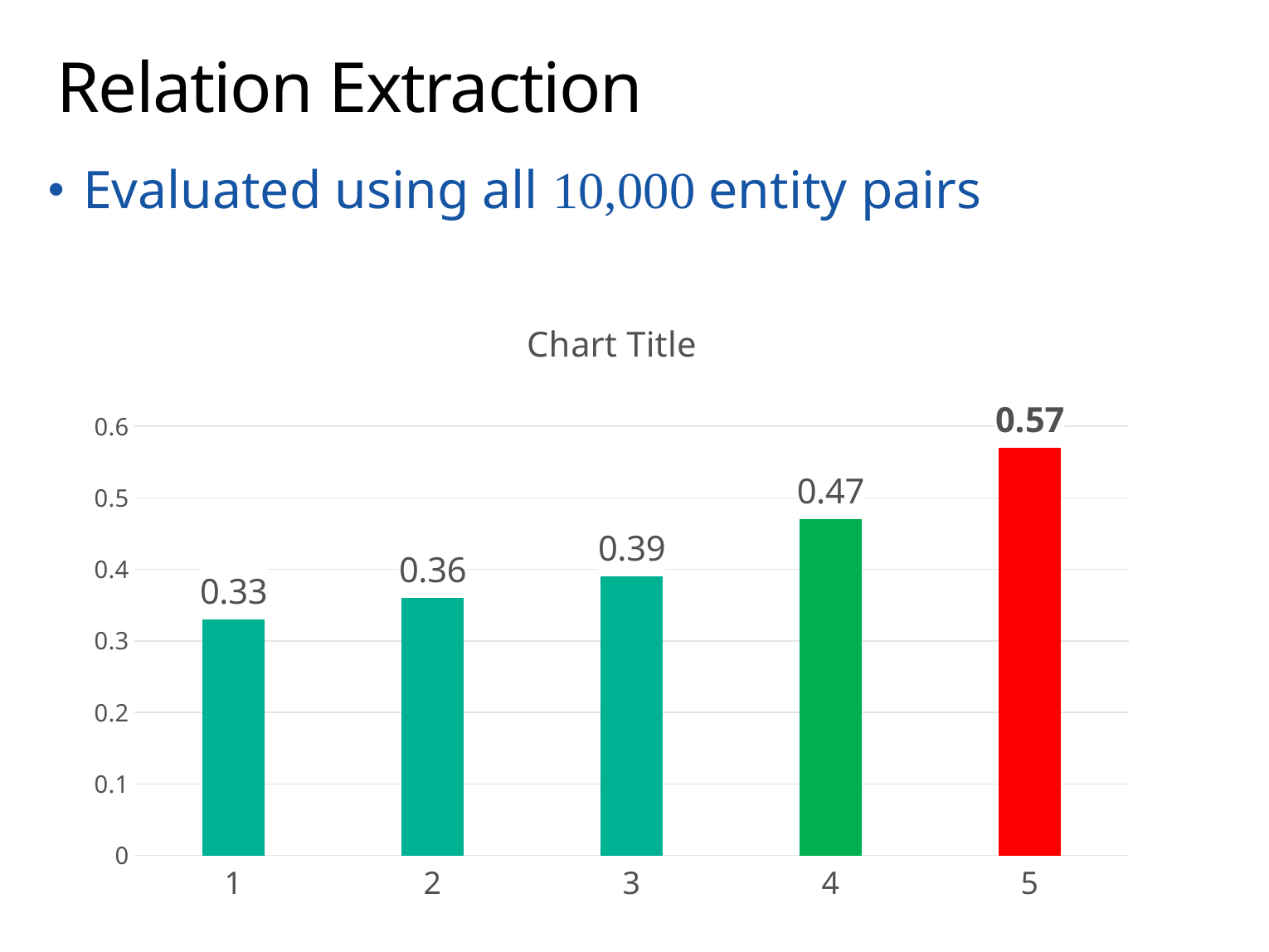
Which category has the highest value? 5 Do the values rise or fall from category 1 to category 5? rise Which category has the lowest value? 1 Which is larger, the value for category 4 or the value for category 3? 4 What is the value for category 3? 0.39 What is the value for category 1? 0.33 What is the difference between the values for category 5 and category 4? 0.10 Is the value for category 4 greater or less than 0.5? less What is the difference between the values for category 2 and category 1? 0.03 What is the value for category 5? 0.57 How many bars are shown in the chart? 5 What kind of chart is shown on the slide? bar chart